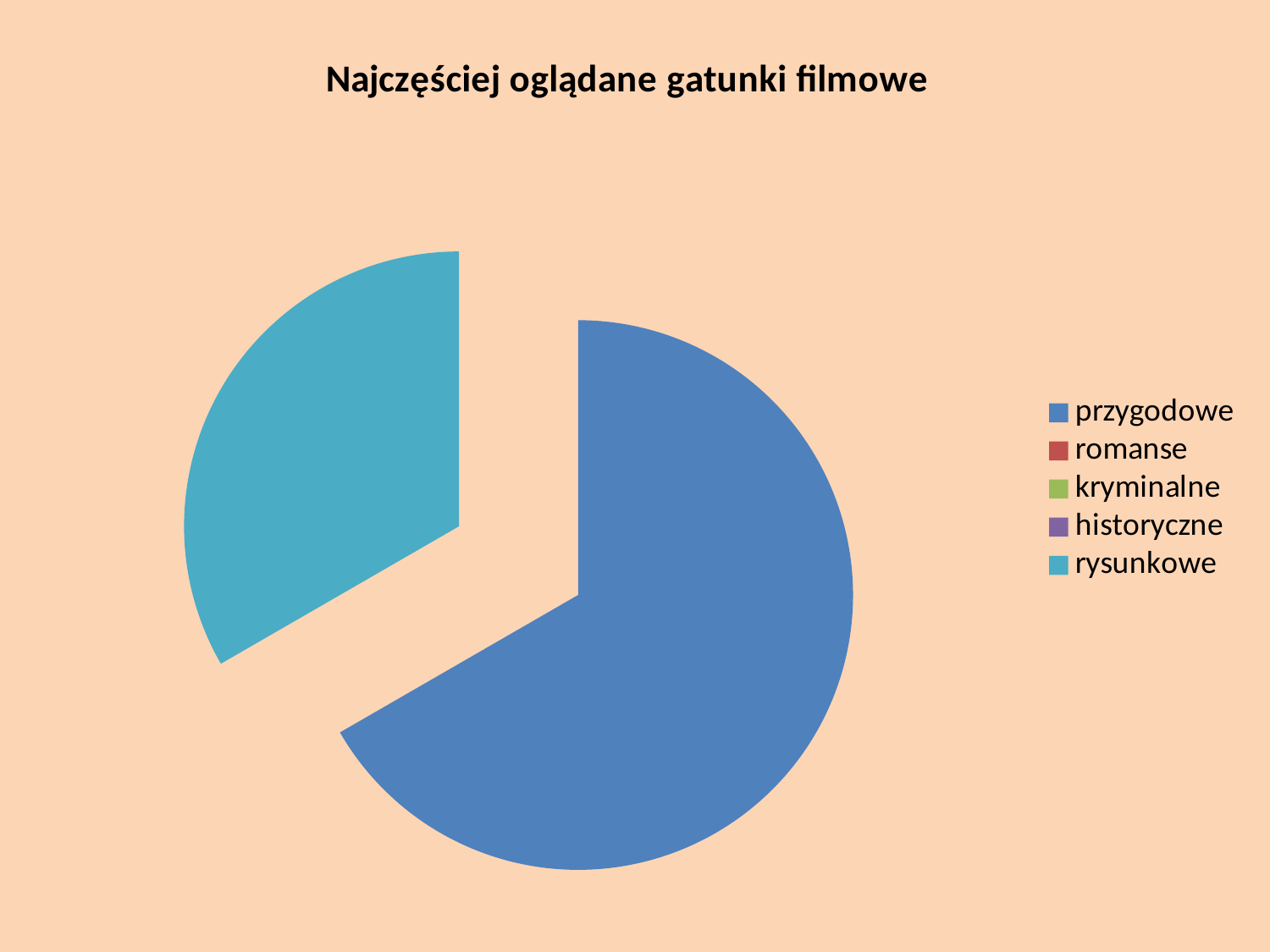
Which category has the largest slice of the pie? przygodowe Which slice is larger, przygodowe or rysunkowe? przygodowe How many entries does the chart's legend list? 5 Which category does the teal (light blue) slice represent? rysunkowe What kind of chart is shown on the slide? pie chart Which legend entry is shown in the dark blue colour of the largest slice? przygodowe What is the title of the chart? Najczęściej oglądane gatunki filmowe How many slices are visible in the pie? 2